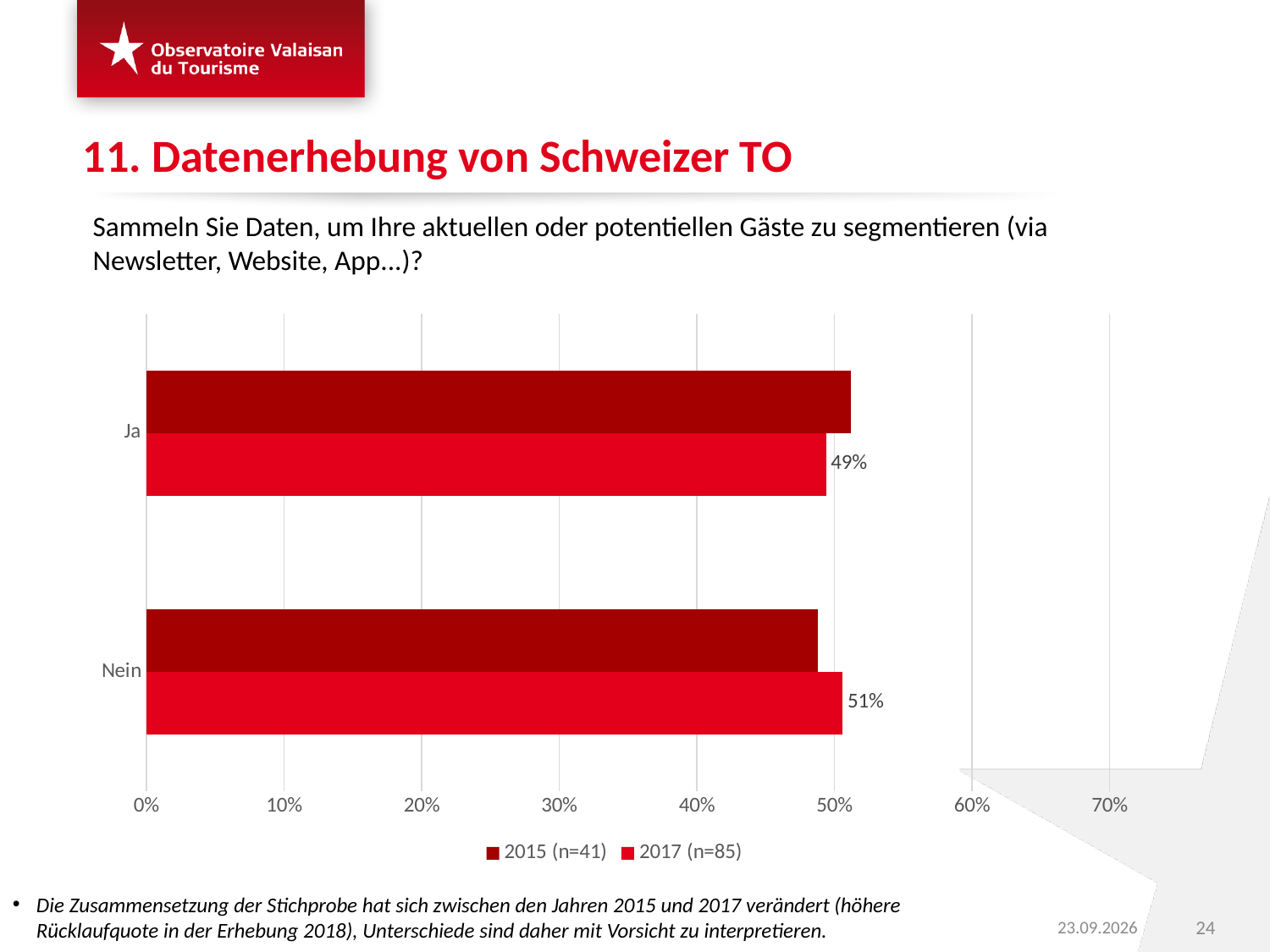
What is the value for "Ja" in the 2017 (n=85) series? 49% What is the value for "Nein" in the 2017 (n=85) series? 51% What is the difference between the 2017 values for Nein and Ja? 2% What are the two series named in the legend? 2015 (n=41) and 2017 (n=85) In the 2017 (n=85) series, which category has the higher value, Ja or Nein? Nein What is the highest percentage tick shown on the x axis? 70% How many series does the legend list? 2 In the 2017 (n=85) series, which category has the lowest value? Ja How many categories are shown on the chart? 2 Is the value for "Nein" in the 2015 (n=41) series greater or less than 60%? less Is the value for "Ja" in the 2015 (n=41) series greater or less than 40%? greater What kind of chart is shown on the slide? bar chart